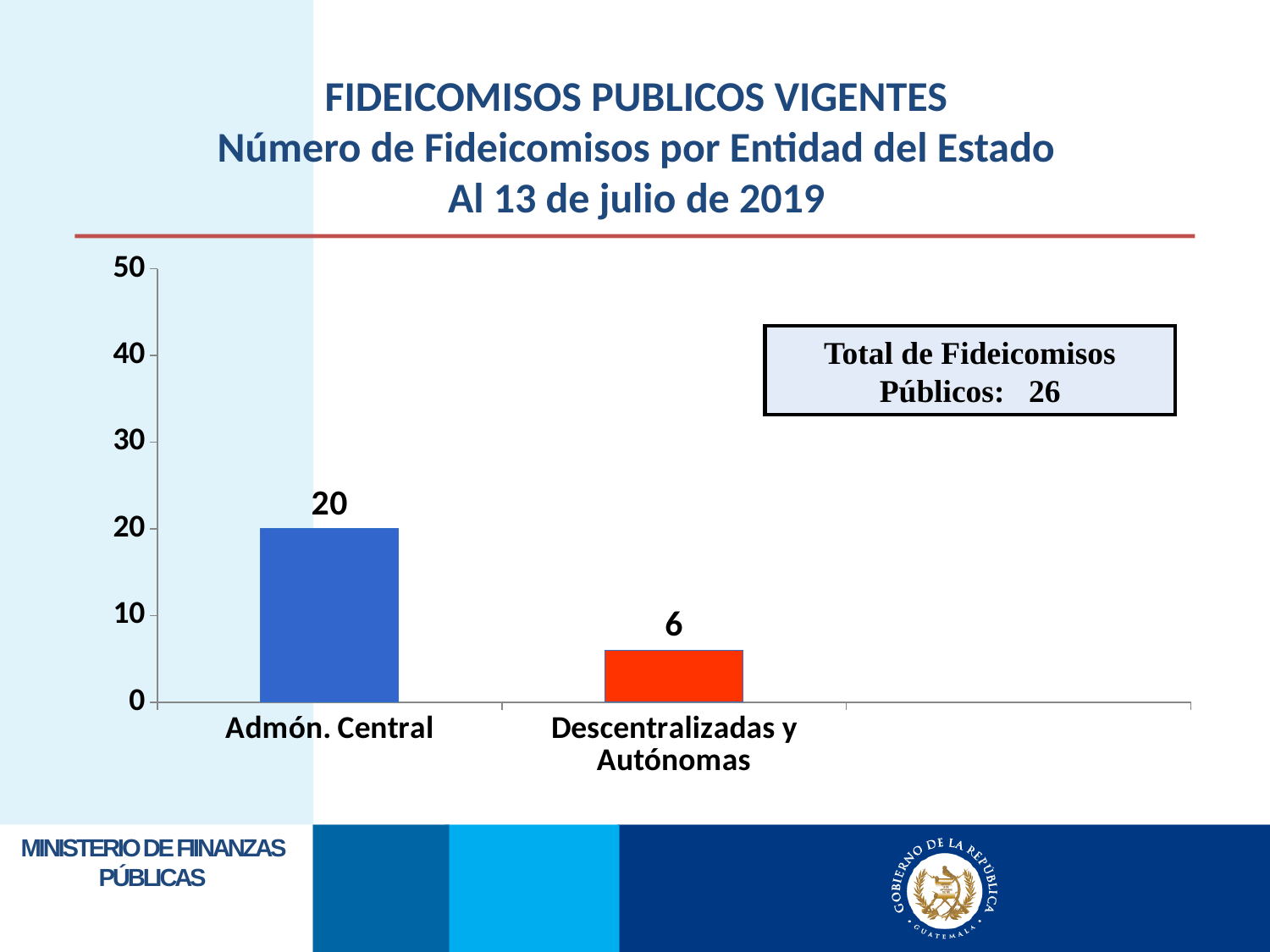
Which is larger, the value for Admón. Central or the value for Descentralizadas y Autónomas? Admón. Central What colour is the bar for Descentralizadas y Autónomas? red Which category has the highest value? Admón. Central What is the value for Descentralizadas y Autónomas? 6 How many categories are shown on the x axis? 2 What is the difference between the values for Admón. Central and Descentralizadas y Autónomas? 14 Is the value for Admón. Central greater or less than 30? less Is the value for Descentralizadas y Autónomas greater or less than 10? less What kind of chart is shown on the slide? bar chart What is the total number of public trusts (Fideicomisos Públicos) stated in the box on the slide? 26 What is the value for Admón. Central? 20 Which category has the lowest value? Descentralizadas y Autónomas